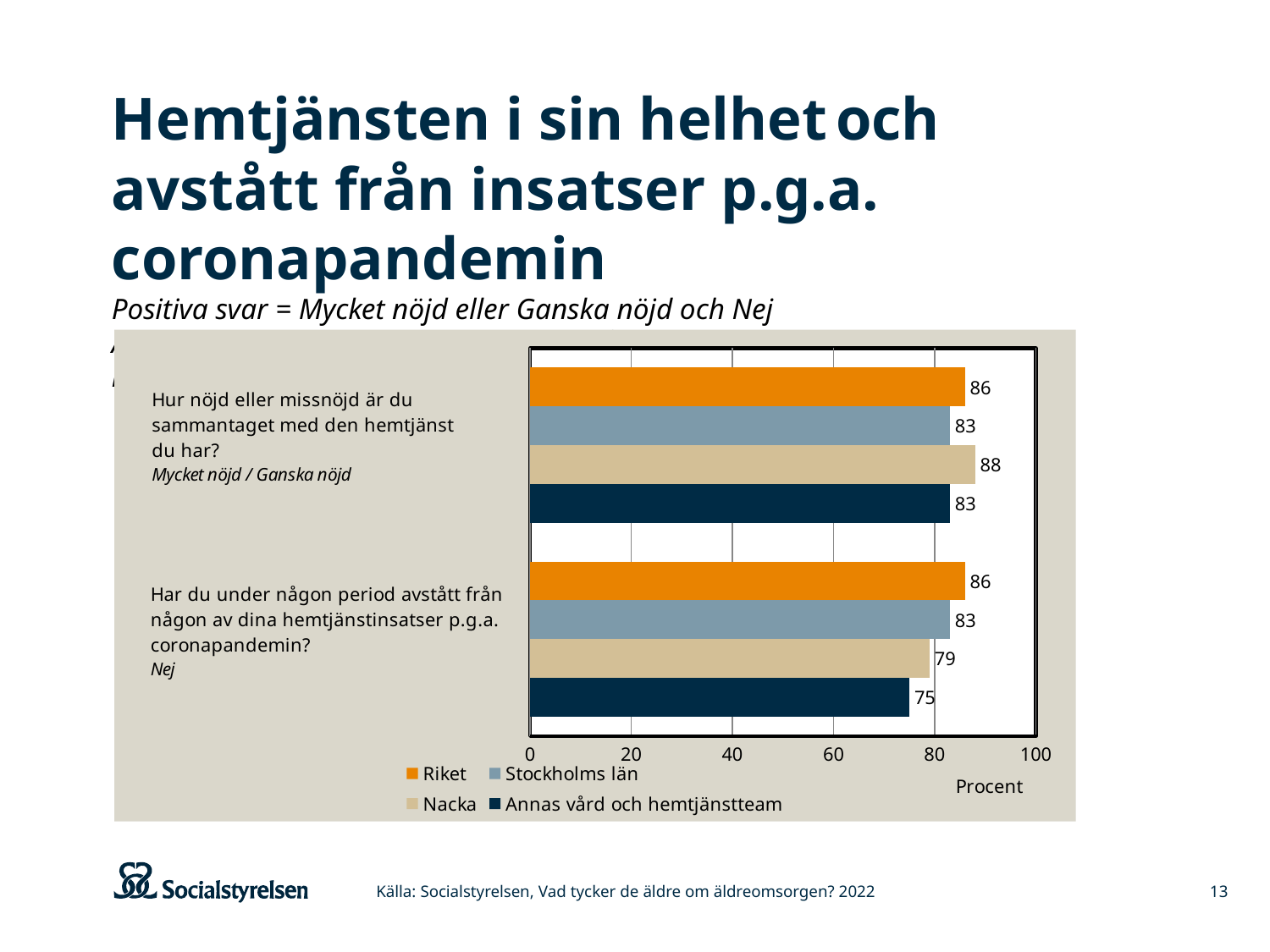
What unit is shown on the horizontal axis of the chart? Procent What is the value for Nacka on the question "Hur nöjd eller missnöjd är du sammantaget med den hemtjänst du har?"? 88 What is the value for Riket on the question "Har du under någon period avstått från någon av dina hemtjänstinsatser p.g.a. coronapandemin?"? 86 Which series has the lowest value on the question "Har du under någon period avstått från någon av dina hemtjänstinsatser p.g.a. coronapandemin?"? Annas vård och hemtjänstteam Which series has the highest value on the question "Hur nöjd eller missnöjd är du sammantaget med den hemtjänst du har?"? Nacka What is the value for Annas vård och hemtjänstteam on the question "Har du under någon period avstått från någon av dina hemtjänstinsatser p.g.a. coronapandemin?"? 75 How many question categories are shown on the chart? 2 What is the difference between the Nacka value and the Annas vård och hemtjänstteam value on the question "Har du under någon period avstått från någon av dina hemtjänstinsatser p.g.a. coronapandemin?"? 4 How many series does the legend list? 4 Which is larger on the question "Har du under någon period avstått från någon av dina hemtjänstinsatser p.g.a. coronapandemin?": the value for Riket or the value for Nacka? Riket What is the value for Stockholms län on the question "Hur nöjd eller missnöjd är du sammantaget med den hemtjänst du har?"? 83 What kind of chart is shown on the slide? bar chart